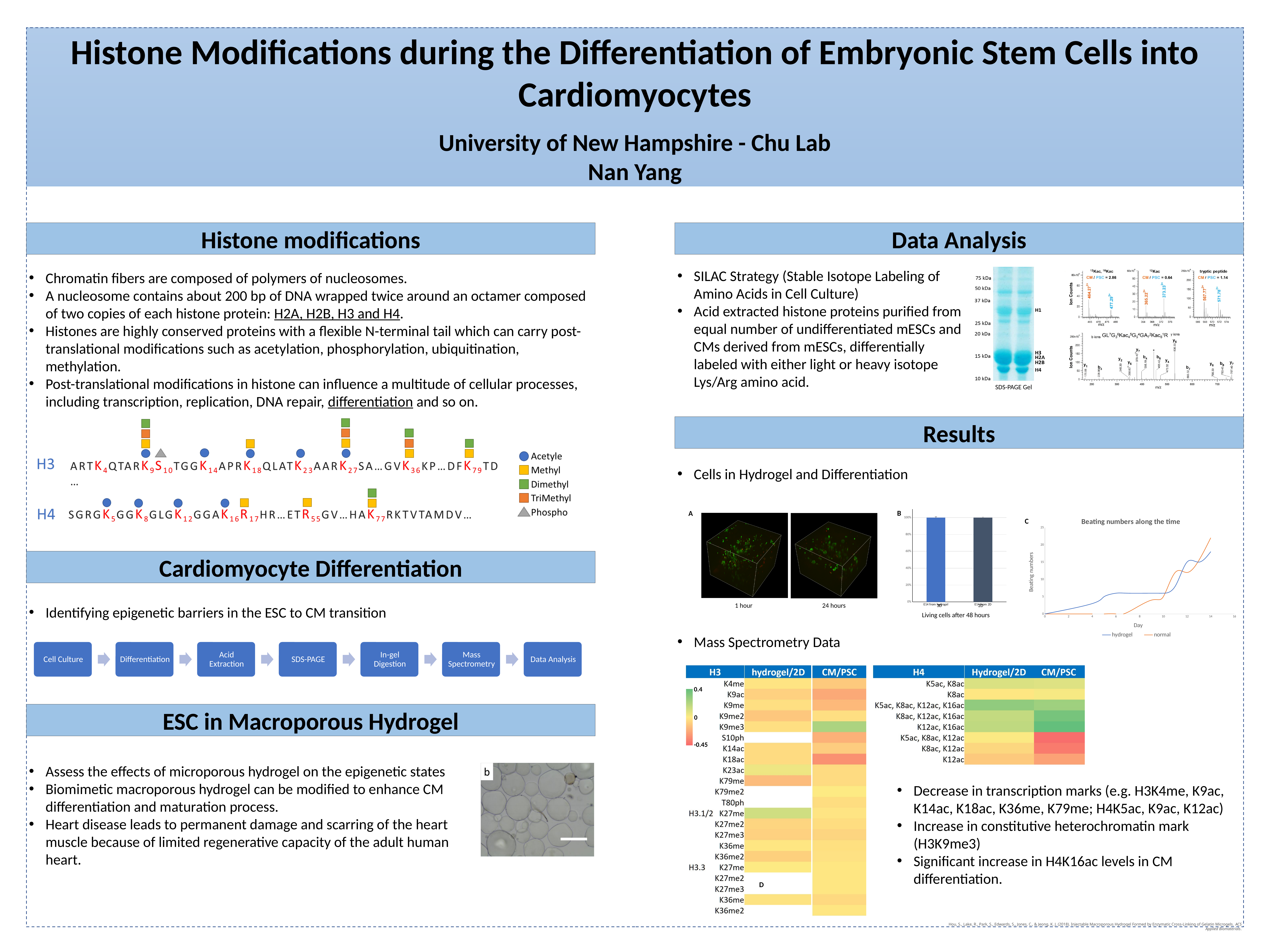
What kind of chart is 'Beating numbers along the time'? line chart In the 'Beating numbers along the time' chart, is the hydrogel value at day 14 greater or less than 15? greater What are the two series named in the legend of the 'Beating numbers along the time' chart? hydrogel and normal In the 'Living cells after 48 hours' chart, is the value of the right bar greater or less than 60%? greater What kind of chart is the 'Living cells after 48 hours' chart? bar chart How many bars are shown in the 'Living cells after 48 hours' chart? 2 In the 'Beating numbers along the time' chart, do the beating numbers rise or fall as the days increase? rise How many series does the legend of the 'Beating numbers along the time' chart list? 2 In the 'Living cells after 48 hours' chart, is the value of the left bar greater or less than 80%? greater In the 'Beating numbers along the time' chart, which series reaches the higher value at day 14, hydrogel or normal? normal What is the x-axis label of the 'Beating numbers along the time' chart? Day In the 'Beating numbers along the time' chart, which series has the higher value at day 8, hydrogel or normal? hydrogel